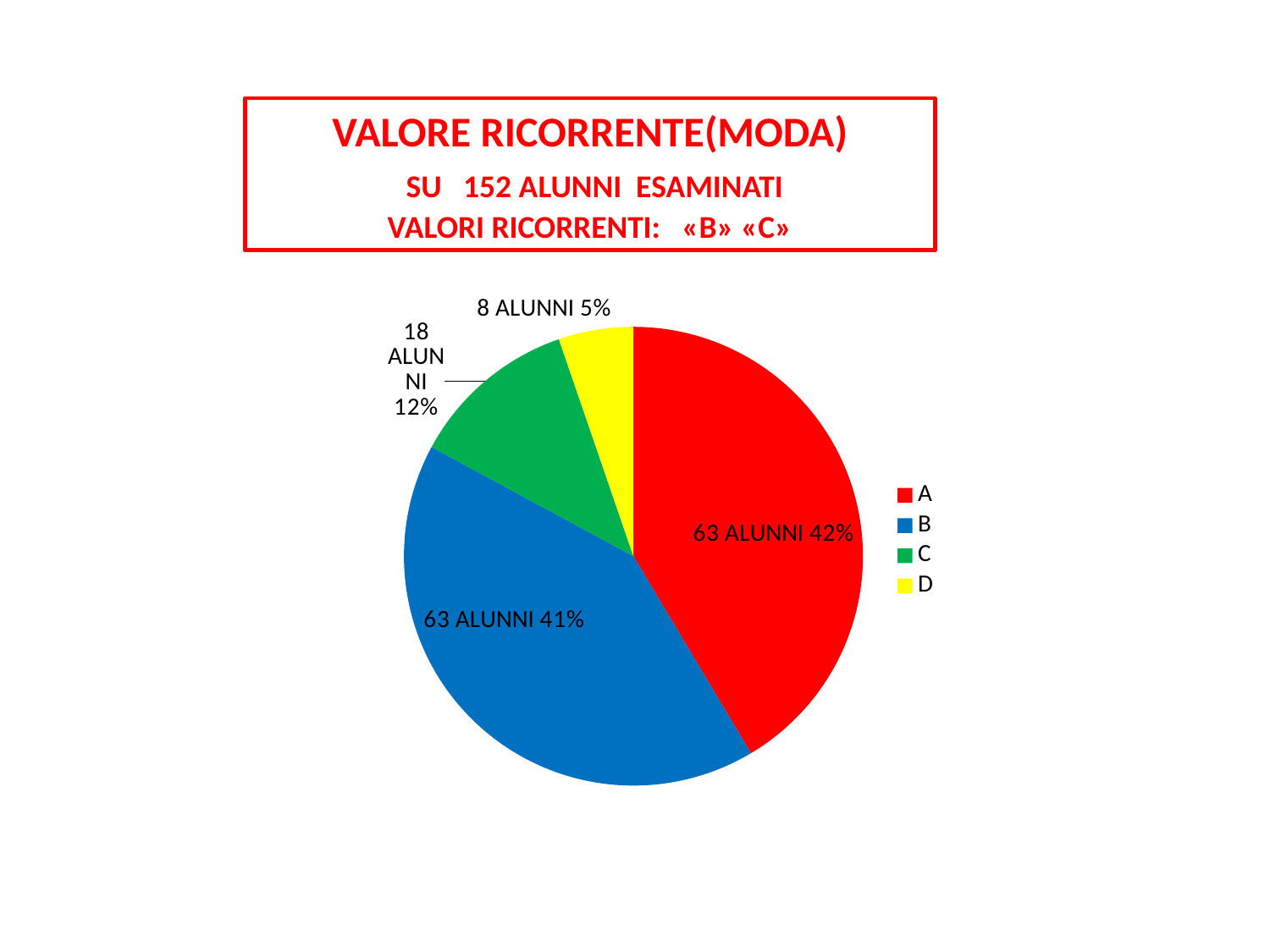
How many entries does the legend of the pie chart list? 4 How many alunni are in category D according to the pie chart label? 8 ALUNNI Which slice is larger in the pie chart, C or D? C What kind of chart is shown on the slide? pie chart What colour is the slice for category C in the pie chart? green What percentage is shown for category D in the pie chart? 5% Which category has the smallest slice in the pie chart? D How many alunni are in category C according to the pie chart label? 18 ALUNNI What percentage is shown for category B in the pie chart? 41% What percentage is shown for category A in the pie chart? 42% What is the difference in number of alunni between category C and category D? 10 How many slices does the pie chart have? 4